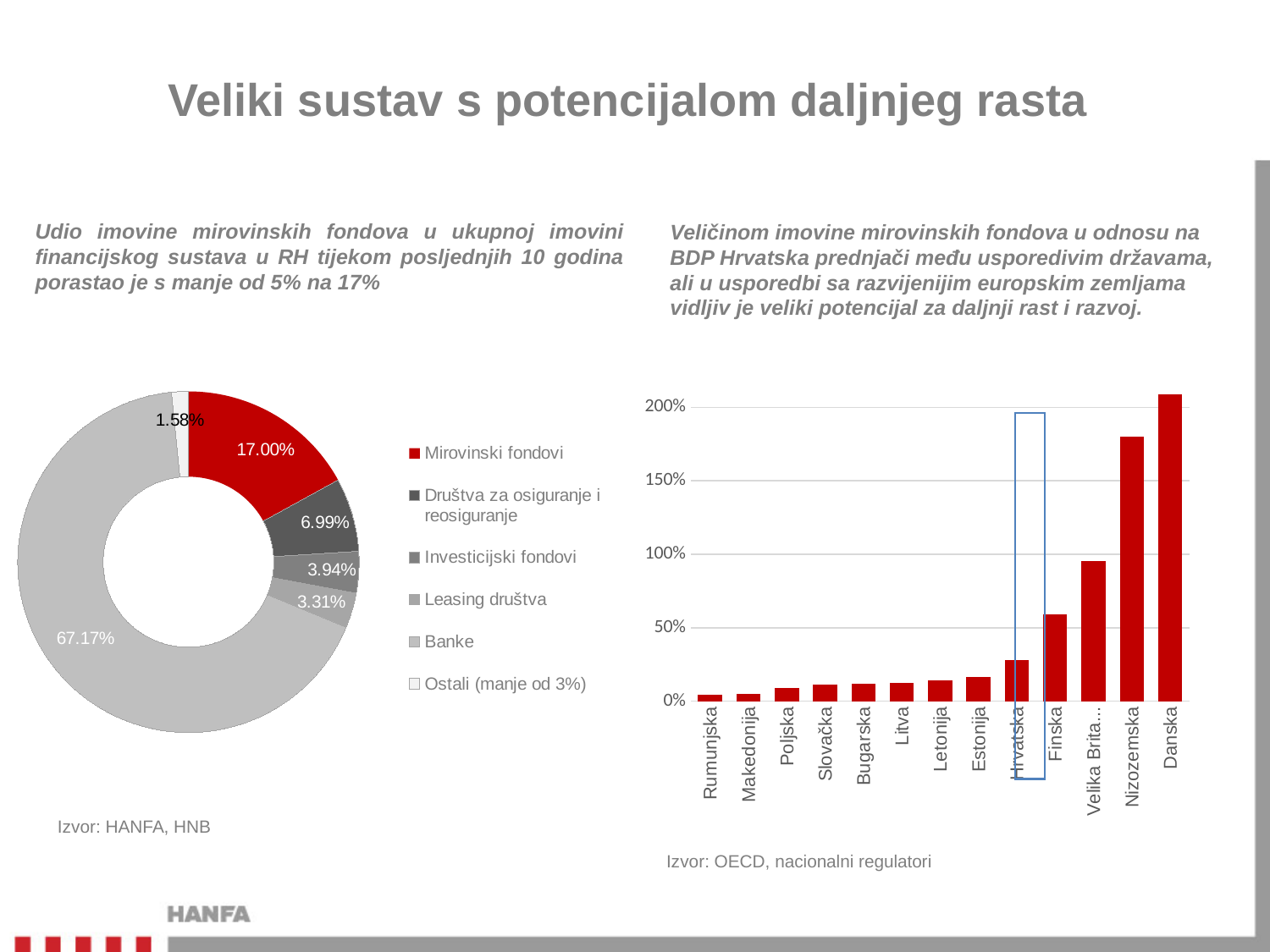
On the right bar chart, how many countries are shown on the x axis? 13 How many entries does the legend of the left donut chart list? 6 On the left donut chart, what share is shown for Mirovinski fondovi? 17.00% On the right bar chart, is the value for Nizozemska greater or less than 150%? greater What kind of chart is the chart on the right side of the slide? Bar chart On the left donut chart, which category has the largest share? Banke On the left donut chart, which category has the smallest share? Ostali (manje od 3%) On the right bar chart, which country has the highest value? Danska On the right bar chart, which country has the lowest value? Rumunjska On the left donut chart, what share is shown for Leasing društva? 3.31% On the left donut chart, what is the difference between the shares of Mirovinski fondovi and Društva za osiguranje i reosiguranje? 10.01% On the left donut chart, what share is shown for Banke? 67.17%